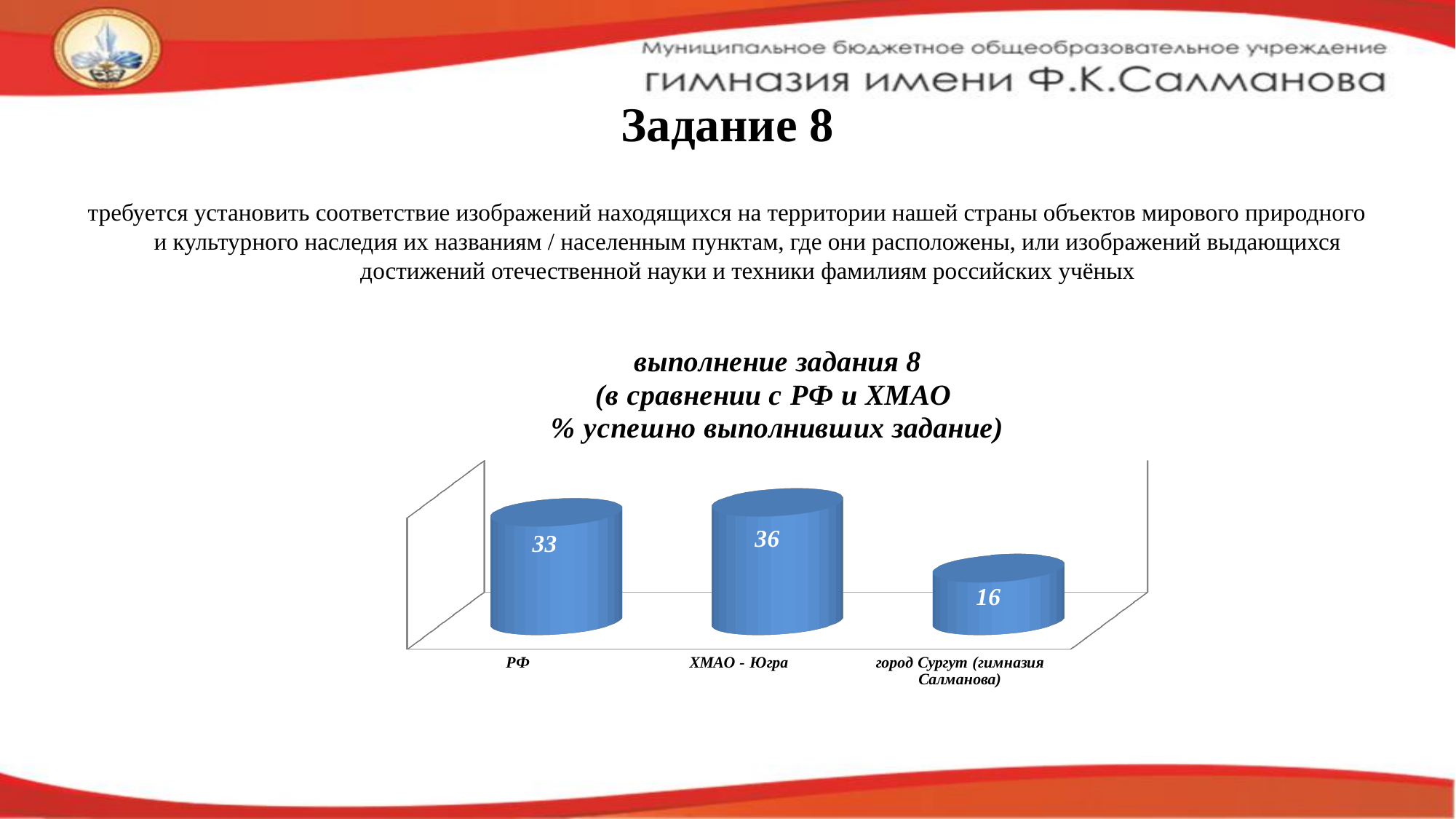
What is the value for город Сургут (гимназия Салманова)? 16 What kind of chart is shown on the slide? bar chart What is the value for ХМАО - Югра? 36 What is the title of the chart? выполнение задания 8 (в сравнении с РФ и ХМАО % успешно выполнивших задание) What colour are the bars in the chart? blue Which category has the lowest value? город Сургут (гимназия Салманова) What is the value for РФ? 33 How many categories are shown in the chart? 3 What is the difference between the values for РФ and город Сургут (гимназия Салманова)? 17 Which category has the highest value? ХМАО - Югра Which is larger, the value for РФ or the value for город Сургут (гимназия Салманова)? РФ What is the difference between the values for ХМАО - Югра and РФ? 3